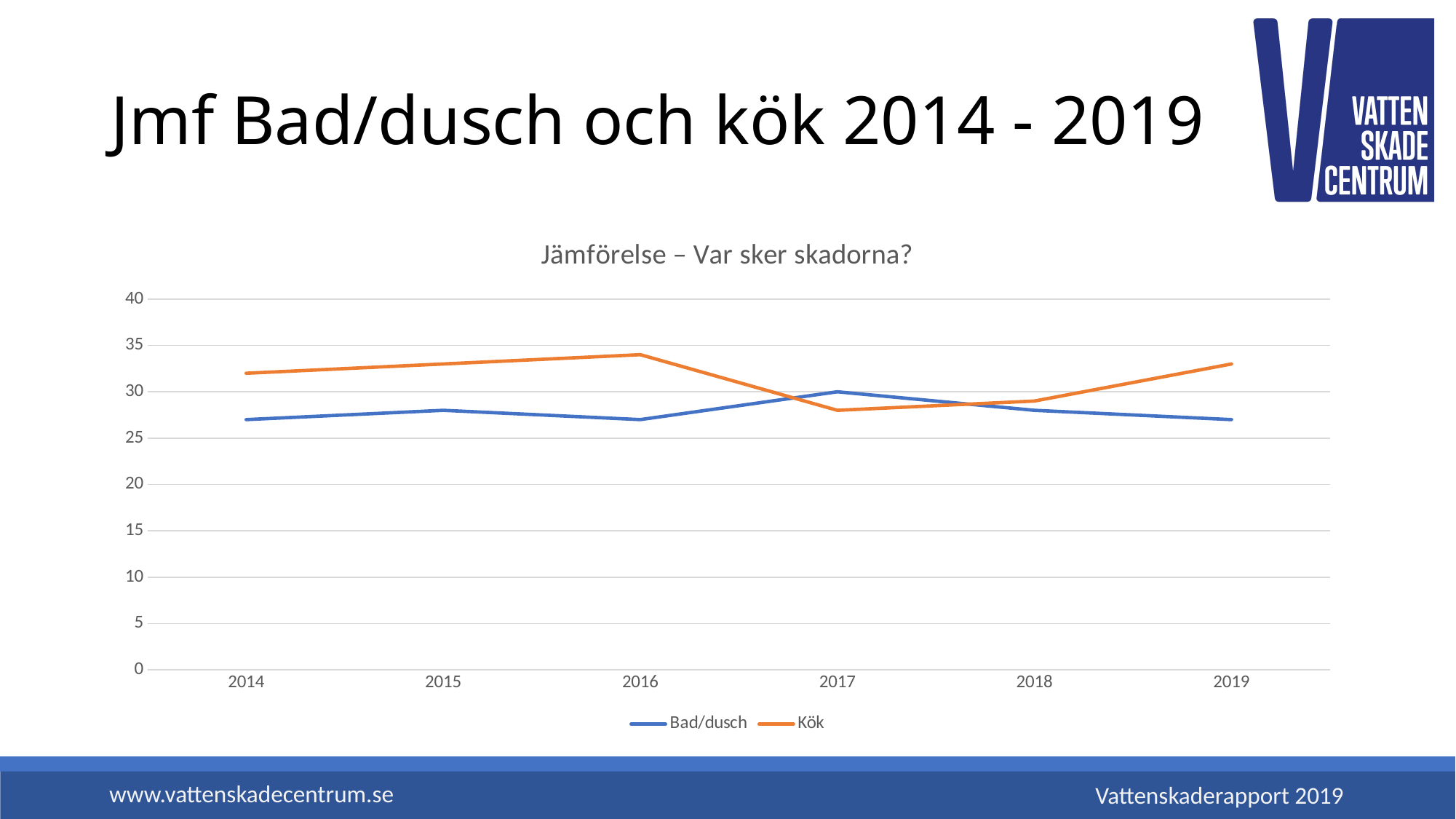
In which year does the Bad/dusch series reach its highest value? 2017 Is the value for Kök in 2017 greater or less than 30? less In 2014, which series has the larger value, Bad/dusch or Kök? Kök Which series is drawn in orange? Kök What is the title of the chart? Jämförelse – Var sker skadorna? In 2017, which series has the larger value, Bad/dusch or Kök? Bad/dusch How many years are plotted along the x axis? 6 How many series does the legend list? 2 What kind of chart is shown on the slide? line chart In which year does the Kök series reach its lowest value? 2017 In which year does the Kök series reach its highest value? 2016 Is the value for Kök in 2016 greater or less than 30? greater